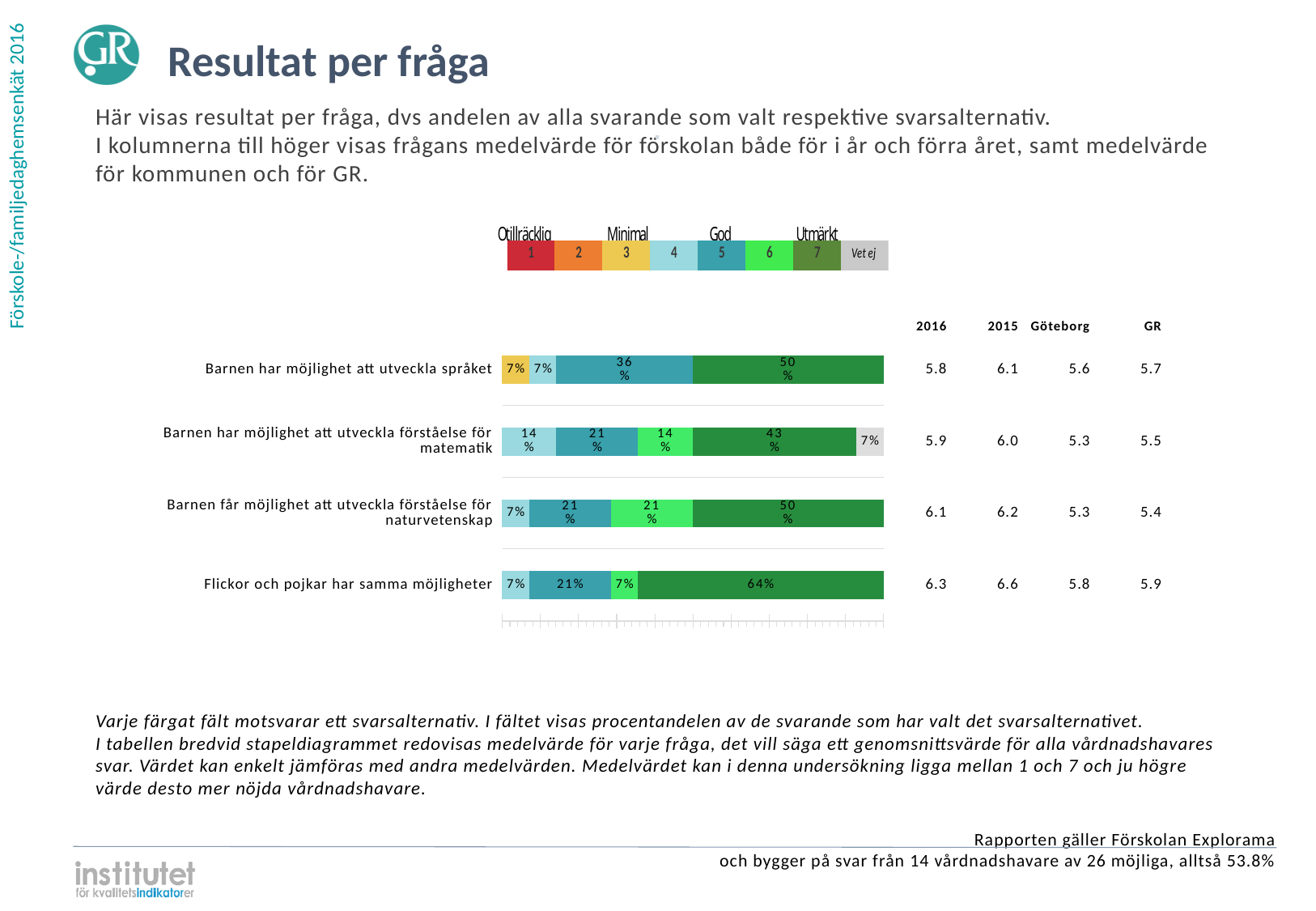
What percentage chose alternative 5 for 'Barnen har möjlighet att utveckla språket'? 36% What kind of chart is shown on the slide? Stacked bar chart How many response alternatives does the legend above the chart list? 8 What is the difference between the alternative 7 share for 'Flickor och pojkar har samma möjligheter' and for 'Barnen har möjlighet att utveckla förståelse för matematik'? 21 percentage points Which question has the smallest share of respondents choosing alternative 7 (Utmärkt)? Barnen har möjlighet att utveckla förståelse för matematik What percentage of respondents chose alternative 7 (Utmärkt) for 'Flickor och pojkar har samma möjligheter'? 64% For 'Barnen får möjlighet att utveckla förståelse för naturvetenskap', is the share for alternative 6 larger or smaller than the share for alternative 4? Larger What is the total of the printed percentages in the bar for 'Barnen har möjlighet att utveckla språket'? 100% What colour represents alternative 7 (Utmärkt) in the legend? Dark green Which question has the largest share of respondents choosing alternative 7 (Utmärkt)? Flickor och pojkar har samma möjligheter What percentage answered 'Vet ej' for 'Barnen har möjlighet att utveckla förståelse för matematik'? 7% How many questions (categories) are plotted in the bar chart? 4